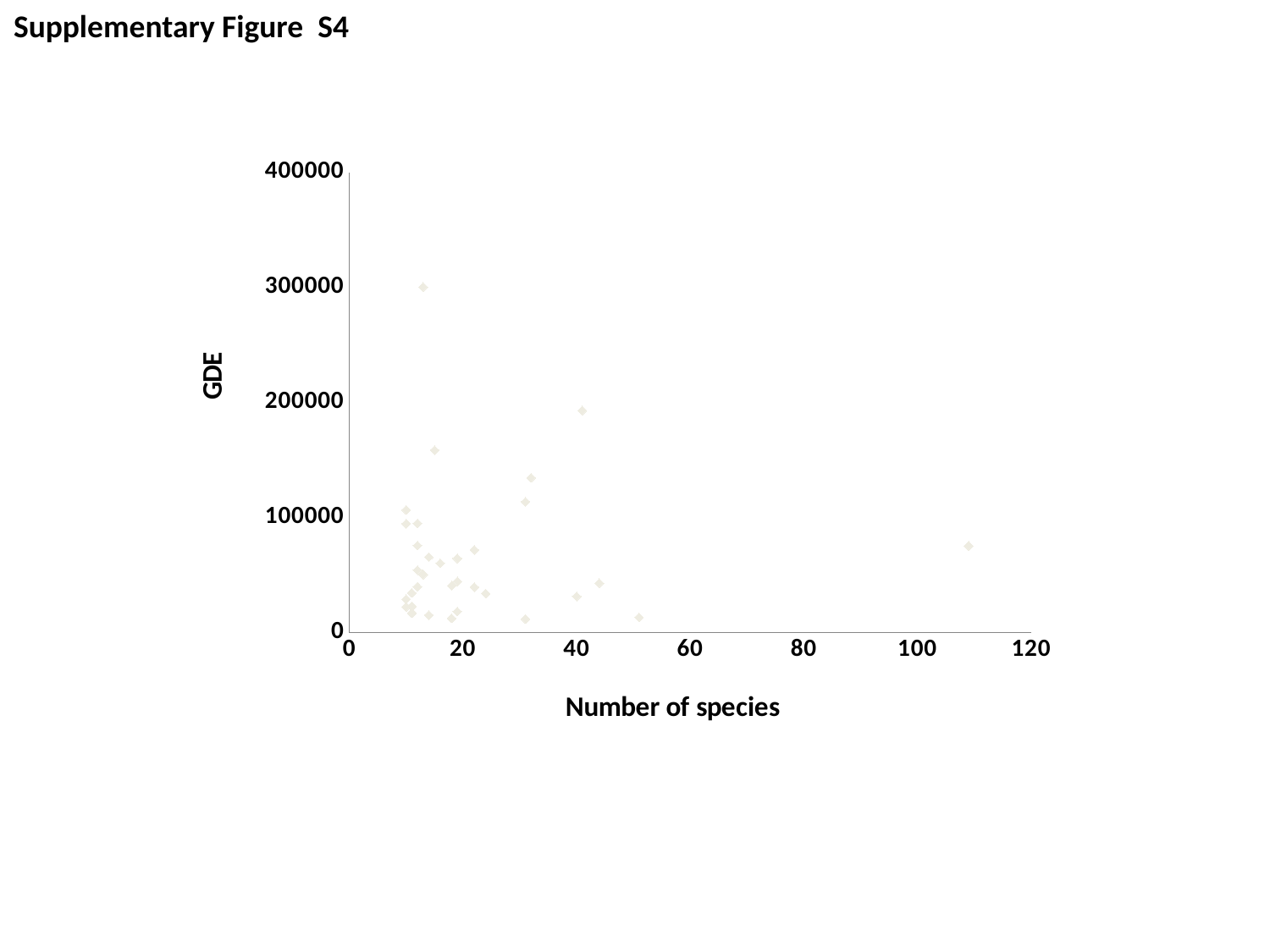
What kind of chart is shown on the slide? scatter chart What is the title of the x axis of the chart? Number of species Is the highest GDE value plotted on the chart greater or less than 400000? less Is the highest GDE value plotted on the chart greater or less than 200000? greater For the point with the largest number of species, is the number of species greater or less than 100? greater What is the maximum value shown on the y axis of the chart? 400000 What is the title of the y axis of the chart? GDE